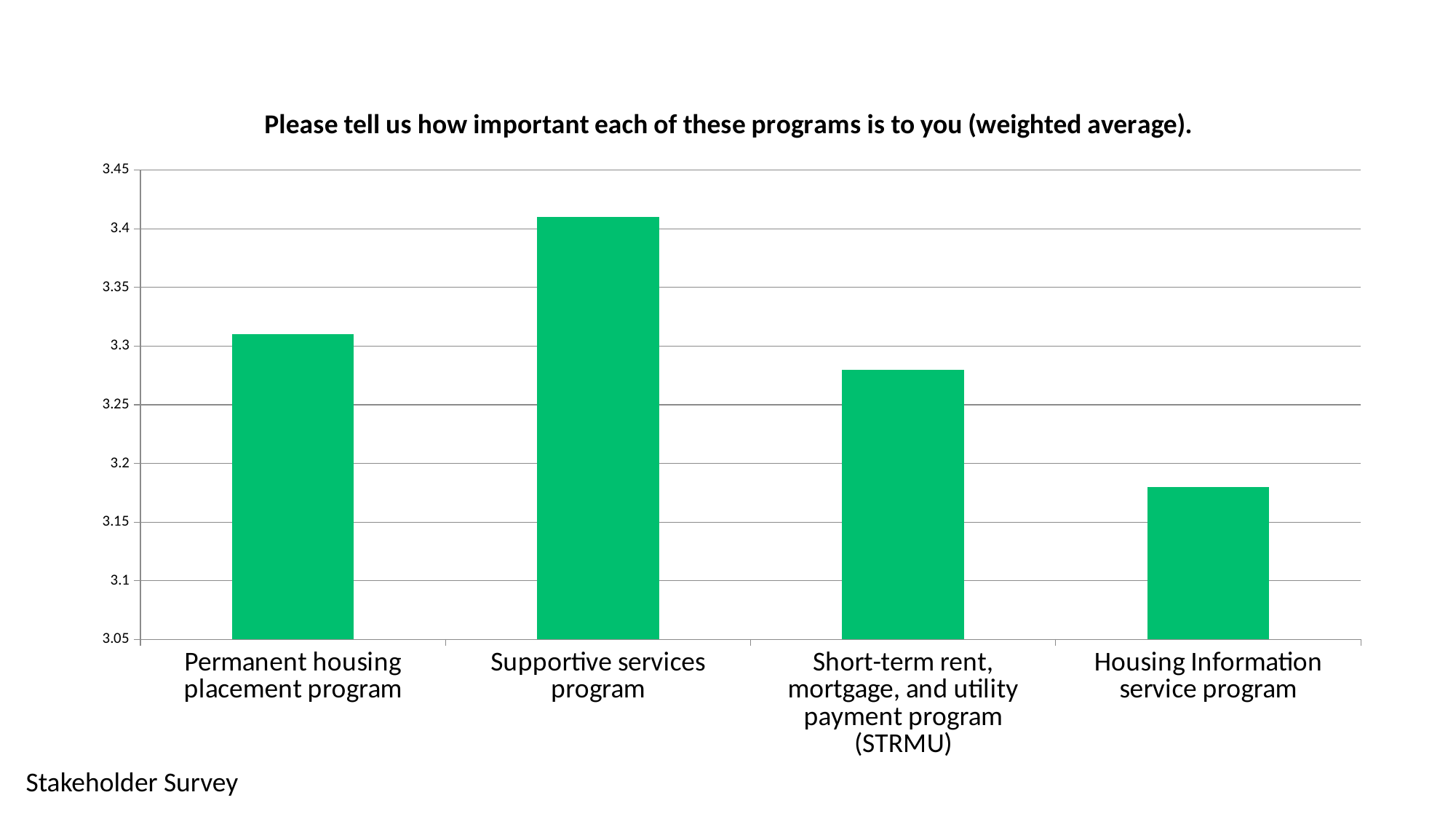
Is the value for Permanent housing placement program greater or less than 3.25? greater Which program has the highest weighted average importance? Supportive services program Which program has the lowest weighted average importance? Housing Information service program What kind of chart is shown on the slide? bar chart What is the title of the chart? Please tell us how important each of these programs is to you (weighted average). What colour are the bars in the chart? green Which is larger: the value for Supportive services program or the value for Short-term rent, mortgage, and utility payment program (STRMU)? Supportive services program Is the value for Supportive services program greater or less than 3.35? greater Is the value for Housing Information service program greater or less than 3.2? less How many programs are shown on the chart? 4 Which is larger: the value for Permanent housing placement program or the value for Housing Information service program? Permanent housing placement program